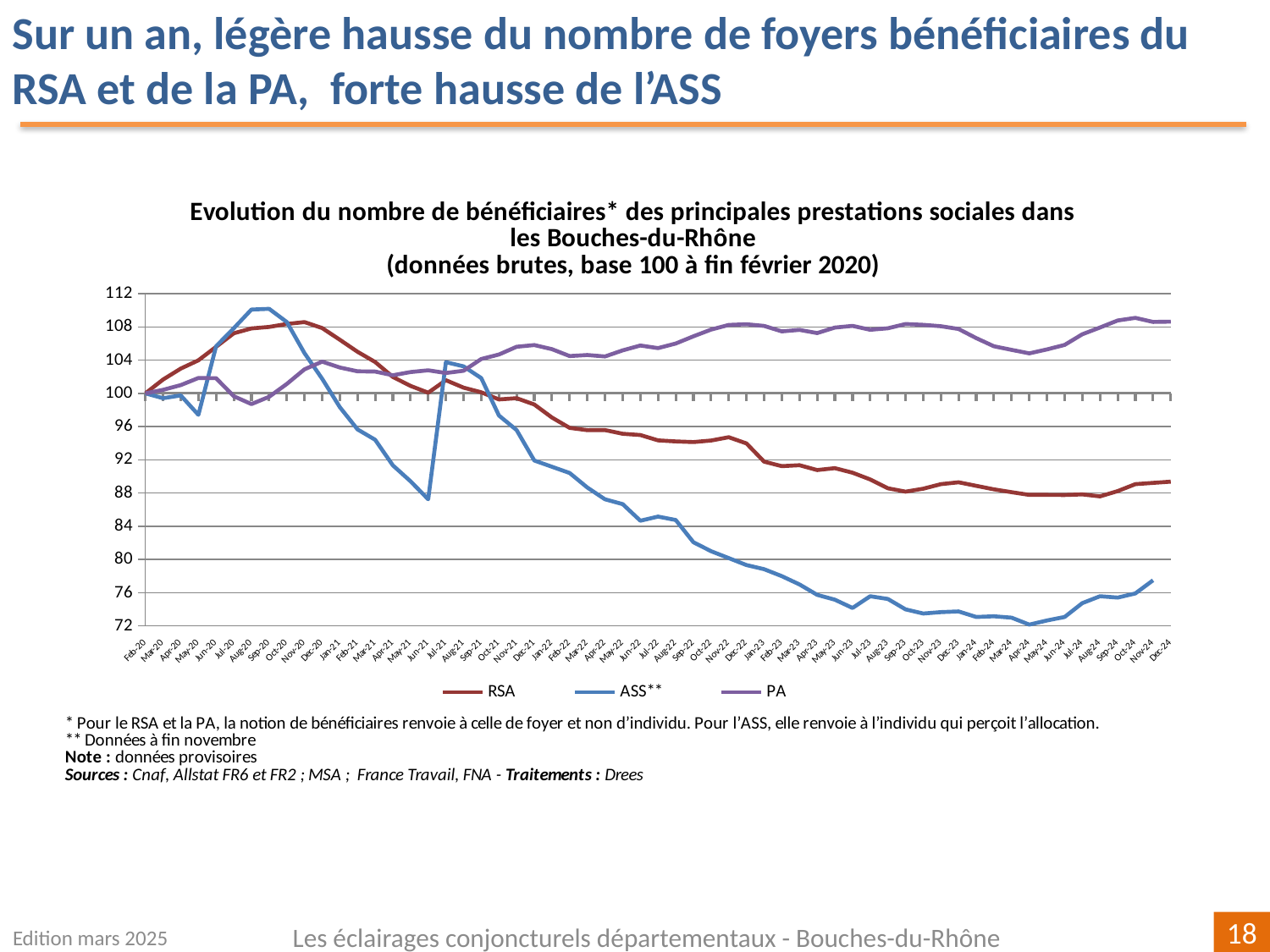
Which series are listed in the legend? RSA, ASS**, PA How many series does the legend list? 3 Is the value for PA at Dec-24 greater or less than 104? greater What is the base value of the index at the end of February 2020, according to the chart title? 100 Is the value for ASS** at May-24 greater or less than 76? less Which series has the highest value at Dec-24? PA Does the ASS** series rise or fall between Sep-20 and May-24? fall What kind of chart is shown on the slide? line chart Is the value for RSA at Dec-24 greater or less than 92? less